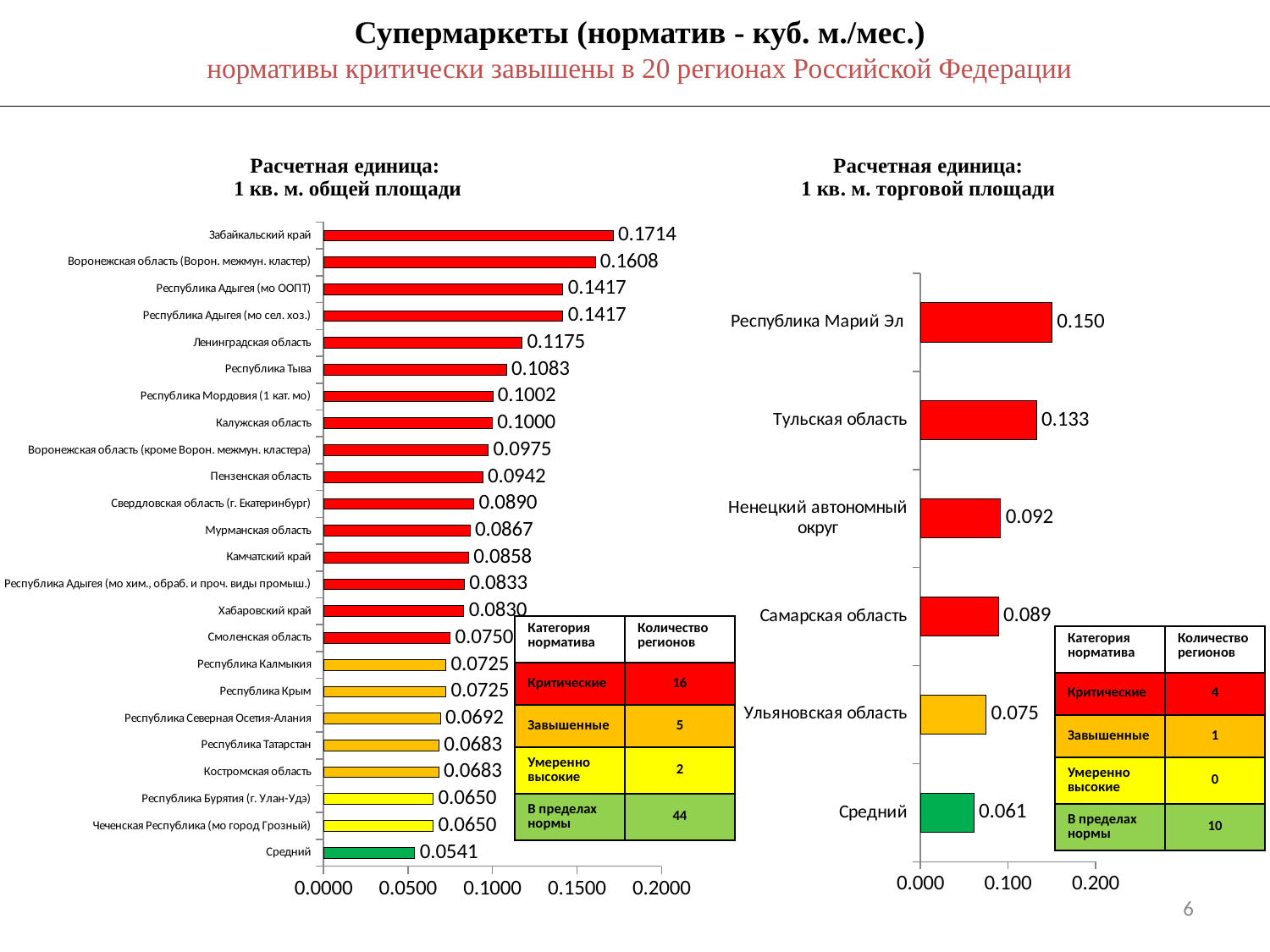
On the right chart (1 кв. м. торговой площади), how many categories are shown? 6 On the right chart (1 кв. м. торговой площади), what is the difference between Ненецкий автономный округ and Самарская область? 0.003 On the left chart (1 кв. м. общей площади), how many bars are plotted? 24 On the right chart (1 кв. м. торговой площади), which category has the highest value? Республика Марий Эл What type of chart is the right chart (1 кв. м. торговой площади)? Bar chart On the left chart (1 кв. м. общей площади), which category has the lowest value? Средний On the right chart (1 кв. м. торговой площади), is the value for Ульяновская область greater or less than 0.100? less On the left chart (1 кв. м. общей площади), what is the value for Ленинградская область? 0.1175 On the left chart (1 кв. м. общей площади), which is larger: Калужская область or Пензенская область? Калужская область On the left chart (1 кв. м. общей площади), what is the value for Забайкальский край? 0.1714 On the right chart (1 кв. м. торговой площади), what is the value for Тульская область? 0.133 On the left chart (1 кв. м. общей площади), what is the difference between Забайкальский край and Воронежская область (Ворон. межмун. кластер)? 0.0106